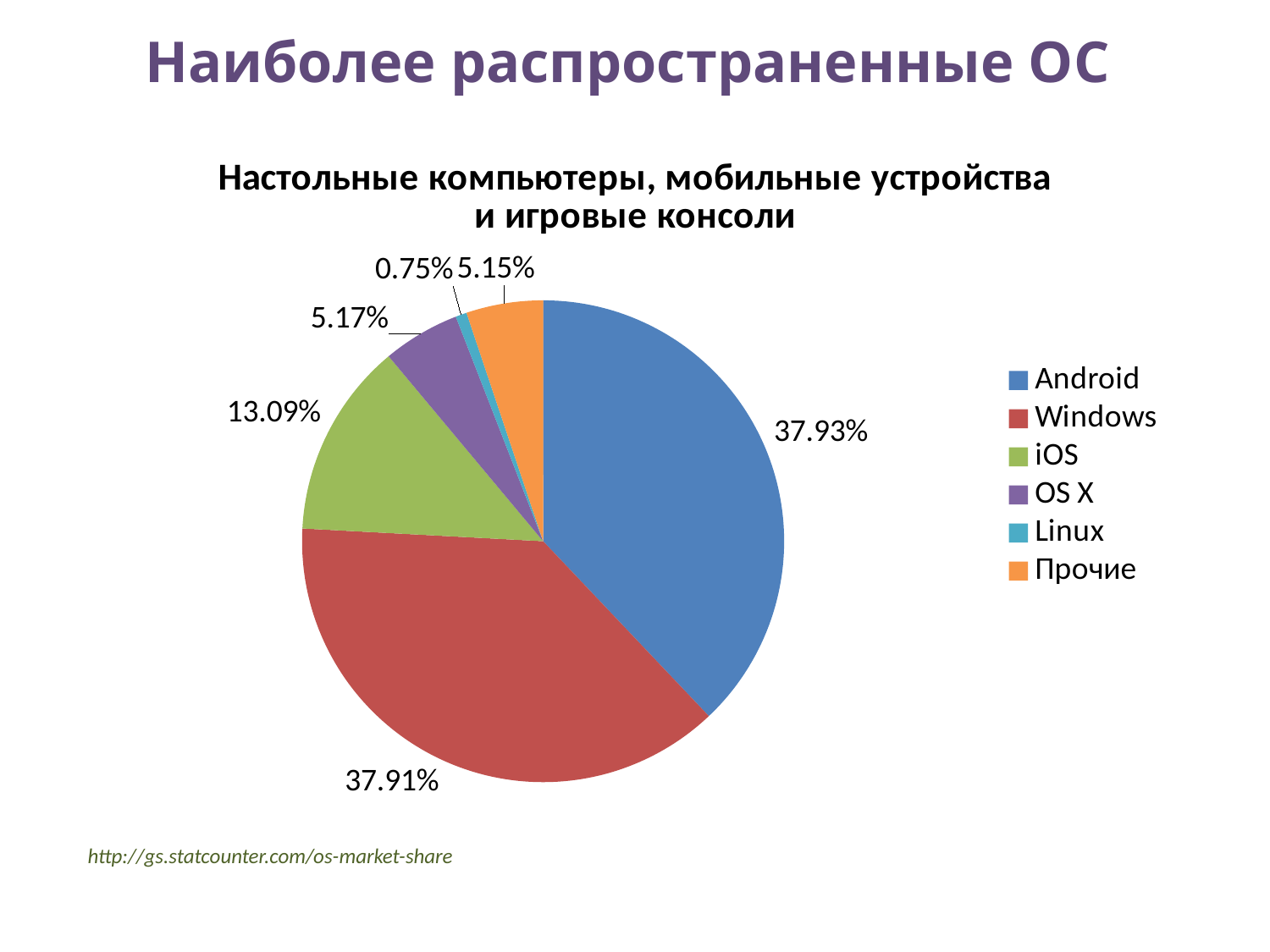
What is the value shown for Windows? 37.91% Which category is shown in green in the legend? iOS What percentage is shown for iOS? 13.09% What is the title of the chart? Настольные компьютеры, мобильные устройства и игровые консоли Which is larger, the slice for iOS or the slice for OS X? iOS What kind of chart is shown on the slide? Pie chart What share is shown for Прочие? 5.15% What is the difference in percentage points between iOS and OS X? 7.92 Which category has the smallest slice of the pie? Linux What share of the pie does Android have? 37.93% What is the value for Linux? 0.75% How many slices does the pie chart have? 6